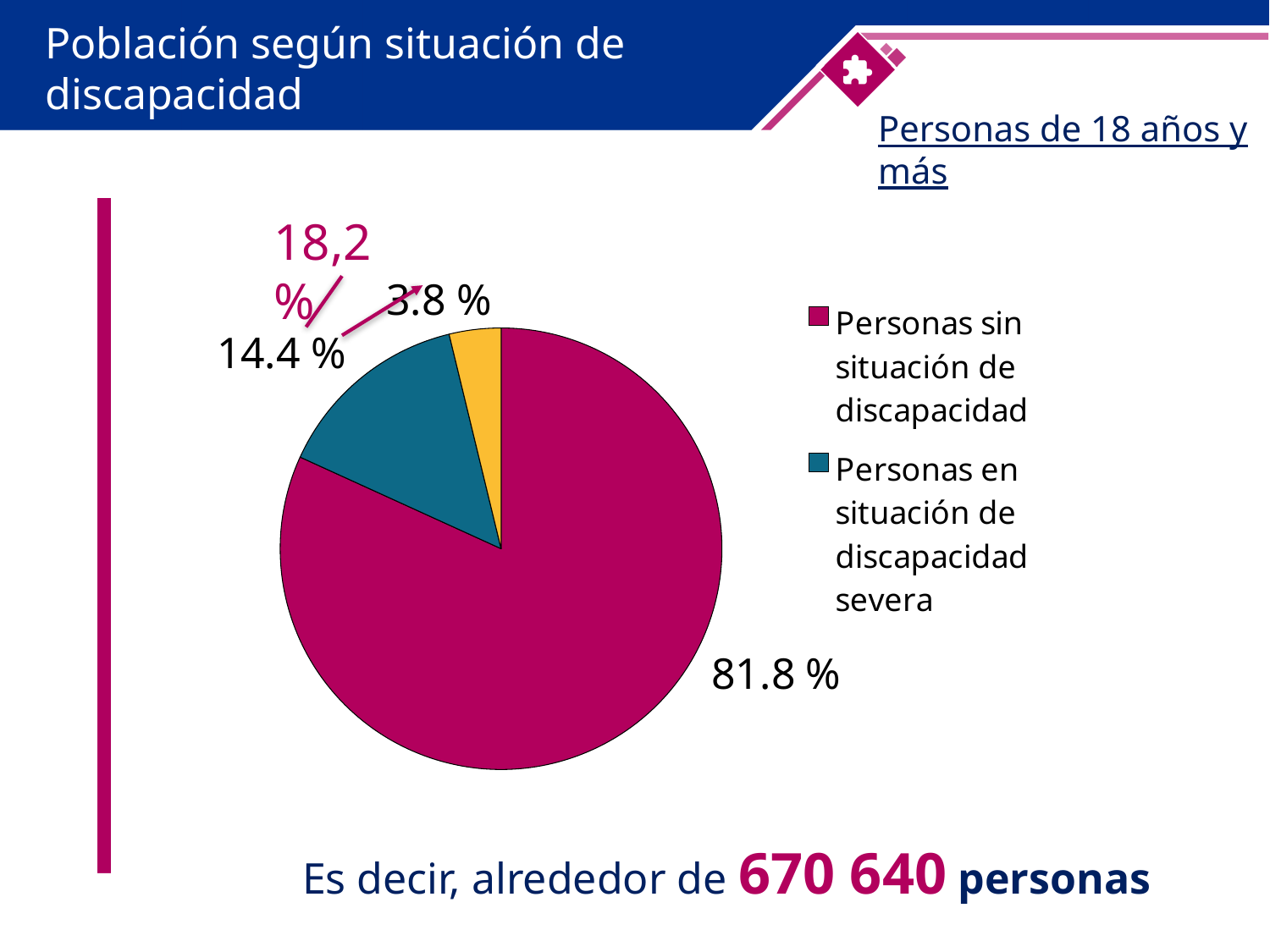
What combined percentage is annotated in magenta above the two smaller slices? 18,2 % What is the value printed on the smallest slice of the pie? 3.8 % What is the title of the chart on the slide? Población según situación de discapacidad How many entries does the legend list? 2 What is the difference between the 81.8 % slice and the 14.4 % slice? 67.4 % What percentage of the pie corresponds to 'Personas sin situación de discapacidad'? 81.8 % What percentage of the pie corresponds to 'Personas en situación de discapacidad severa'? 14.4 % What colour is the slice for 'Personas en situación de discapacidad severa'? teal What kind of chart is shown on the slide? pie chart Which category has the largest slice of the pie? Personas sin situación de discapacidad Which is larger: the slice for 'Personas en situación de discapacidad severa' or the 3.8 % slice? Personas en situación de discapacidad severa How many slices does the pie chart have? 3